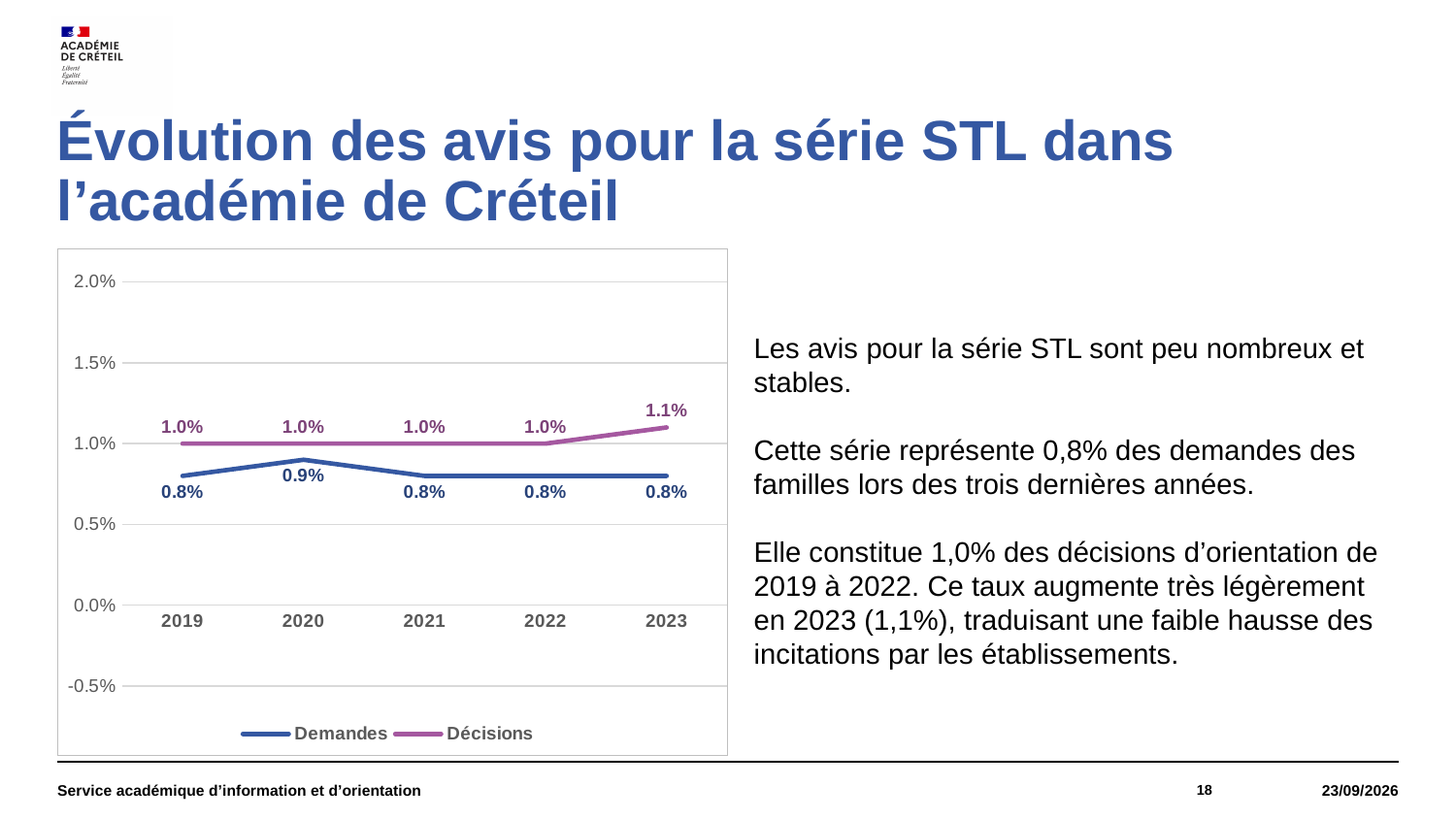
What is the value of Décisions in 2021? 1.0% Does the Décisions series rise or fall between 2022 and 2023? Rise What is the value of Décisions in 2023? 1.1% In which year is the Décisions series highest? 2023 What is the difference between Décisions and Demandes in 2023? 0.3% What kind of chart is shown on the slide? Line chart Which is larger in 2020, Demandes or Décisions? Décisions How many years are shown on the x axis? 5 What is the value of Demandes in 2019? 0.8% In which year is the Demandes series highest? 2020 What is the value of Demandes in 2020? 0.9% How many series does the legend list? 2